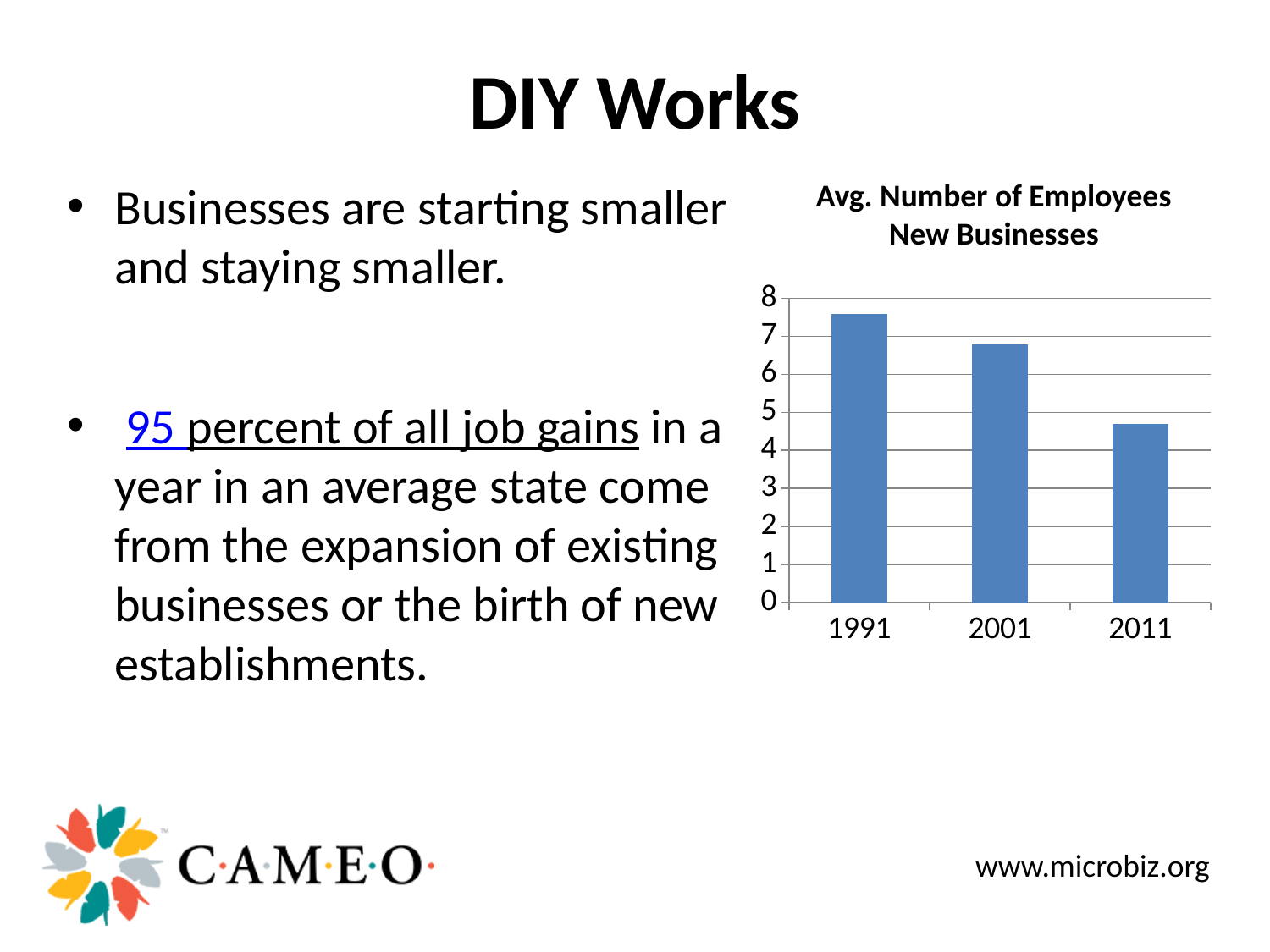
What kind of chart is shown on the slide? bar chart Which year has the highest average number of employees? 1991 Is the value for 2011 greater or less than 5? less What is the title of the chart? Avg. Number of Employees New Businesses Do the values rise or fall from 1991 to 2011? fall Which year has the lowest average number of employees? 2011 How many years are shown on the x axis of the chart? 3 Is the value for 2001 greater or less than 7? less Is the value for 1991 greater or less than 7? greater Which is larger, the value for 2001 or the value for 2011? 2001 What is the highest value shown on the y axis of the chart? 8